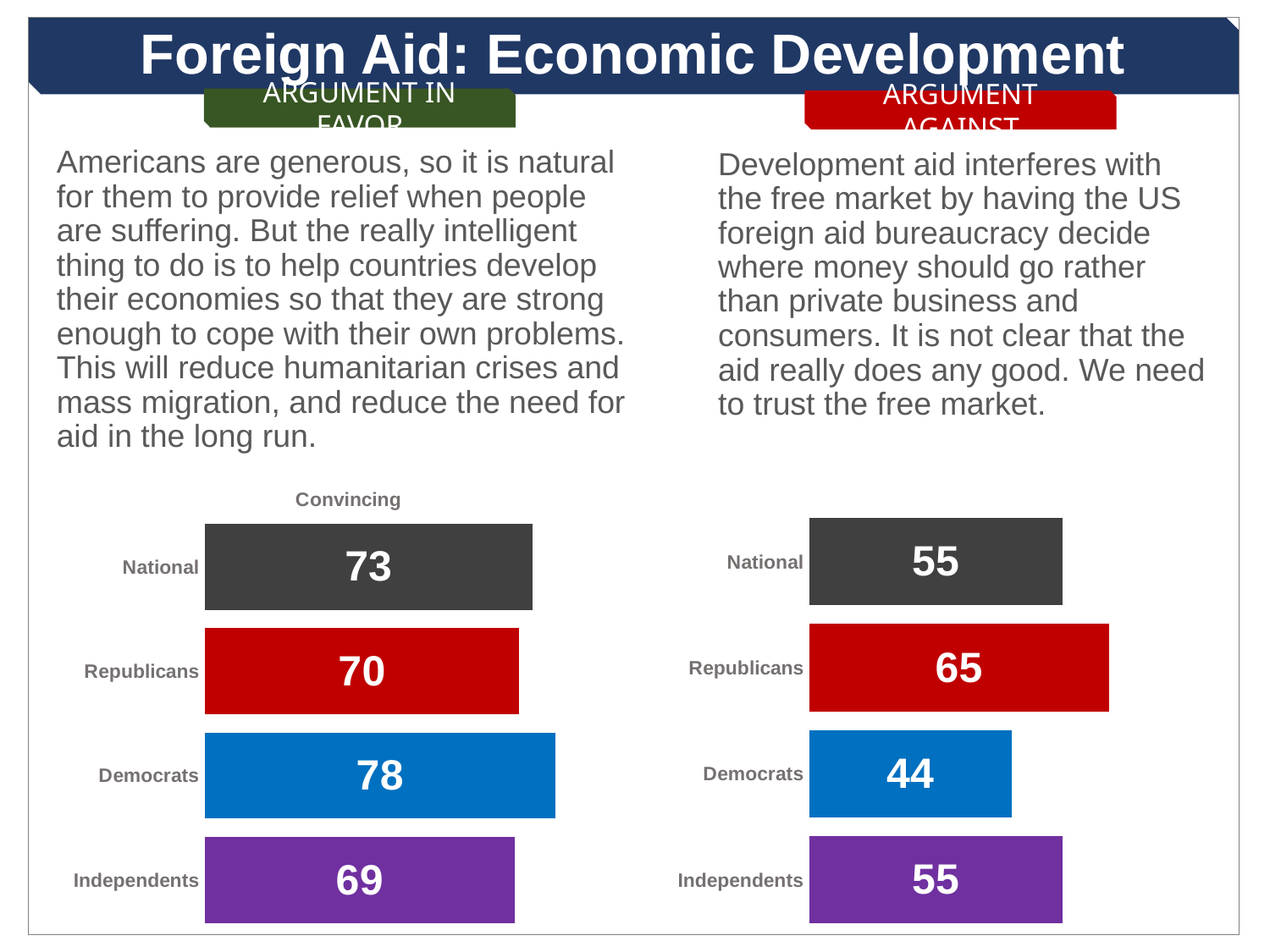
What is the title of the left chart? Convincing In the right chart, what is the difference between the Republicans value and the Democrats value? 21 In the left chart (Convincing), which category has the highest value? Democrats In the right chart, what is the value for Republicans? 65 In the right chart, which category has the lowest value? Democrats In the right chart, which category has the highest value? Republicans What type of chart is the right chart? Bar chart In the left chart (Convincing), what is the difference between the Democrats value and the Republicans value? 8 In the right chart, which is larger, the value for National or the value for Democrats? National In the left chart (Convincing), what is the value for Democrats? 78 How many categories are shown in the left chart (Convincing)? 4 In the left chart (Convincing), which category has the lowest value? Independents